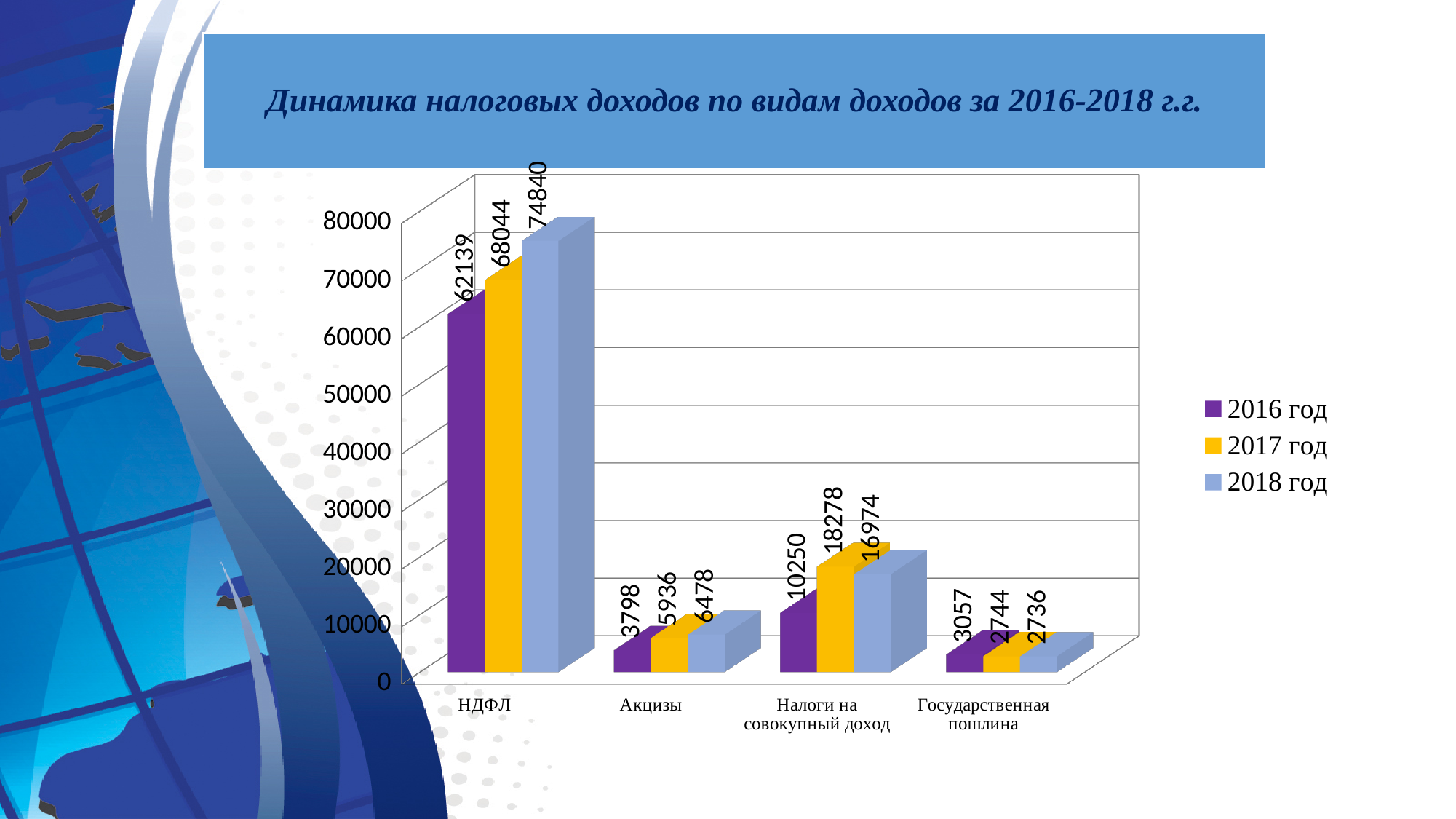
What is the value for Акцизы in 2016 год? 3798 Do the values for Государственная пошлина rise or fall from 2016 год to 2018 год? fall What is the value for НДФЛ in 2018 год? 74840 How many series does the legend list? 3 What is the difference between the 2018 год and 2016 год values for НДФЛ? 12701 What is the value for Государственная пошлина in 2018 год? 2736 What kind of chart is shown on the slide? bar chart Which is larger for Налоги на совокупный доход: the 2017 год value or the 2018 год value? 2017 год Which category has the lowest value in 2016 год? Государственная пошлина How many categories are shown on the x axis? 4 Which category has the highest value in 2017 год? НДФЛ What is the value for Налоги на совокупный доход in 2017 год? 18278